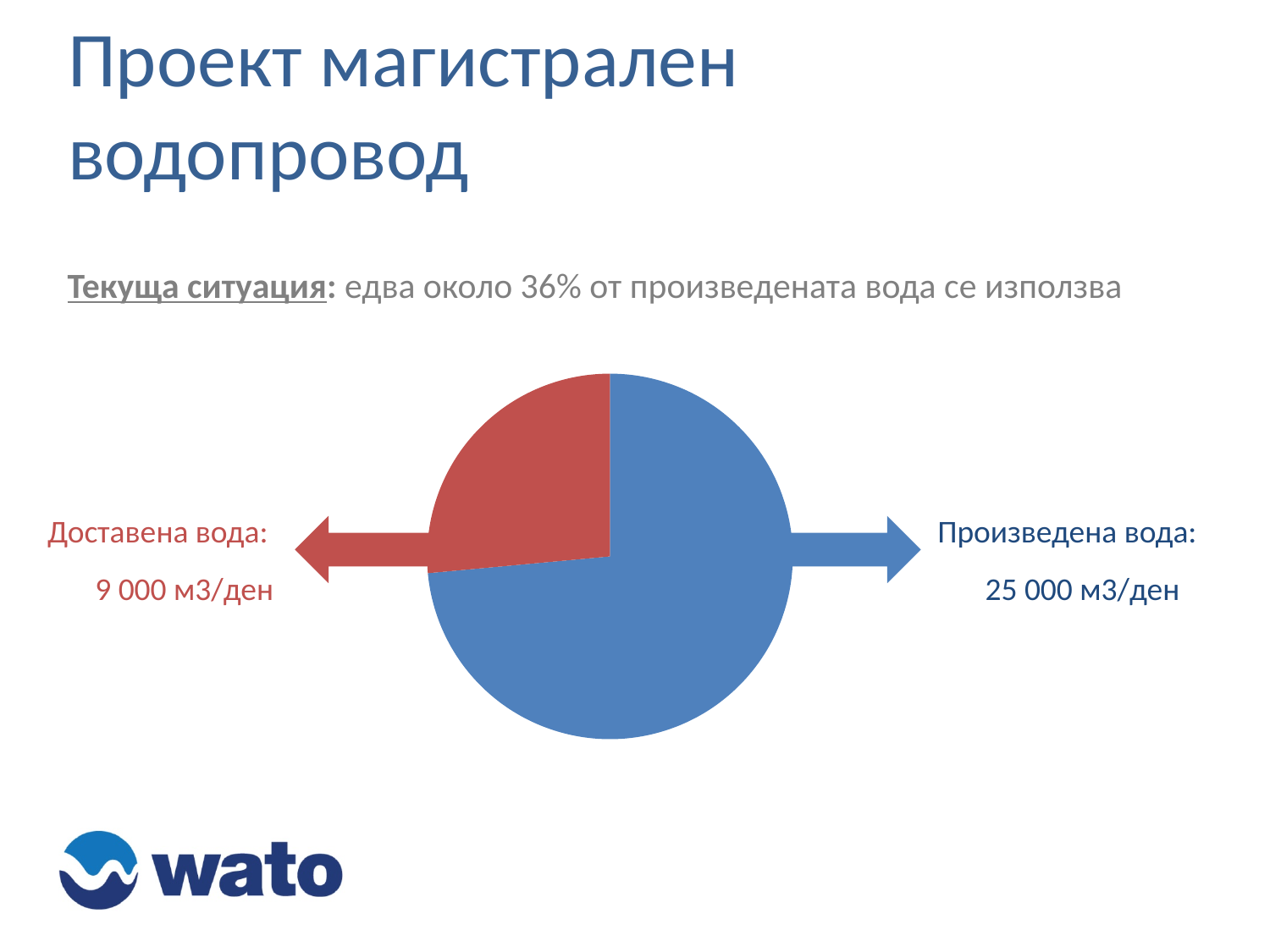
What value is given for Доставена вода? 9 000 м3/ден What is the difference between Произведена вода and Доставена вода? 16 000 м3/ден What kind of chart is shown on the slide? pie chart What colour is the slice for Доставена вода? red How many slices does the pie chart have? 2 Which is larger, Доставена вода or Произведена вода? Произведена вода What value is given for Произведена вода? 25 000 м3/ден Which slice of the pie chart is the largest? Произведена вода What colour is the slice for Произведена вода? blue Which slice of the pie chart is the smallest? Доставена вода